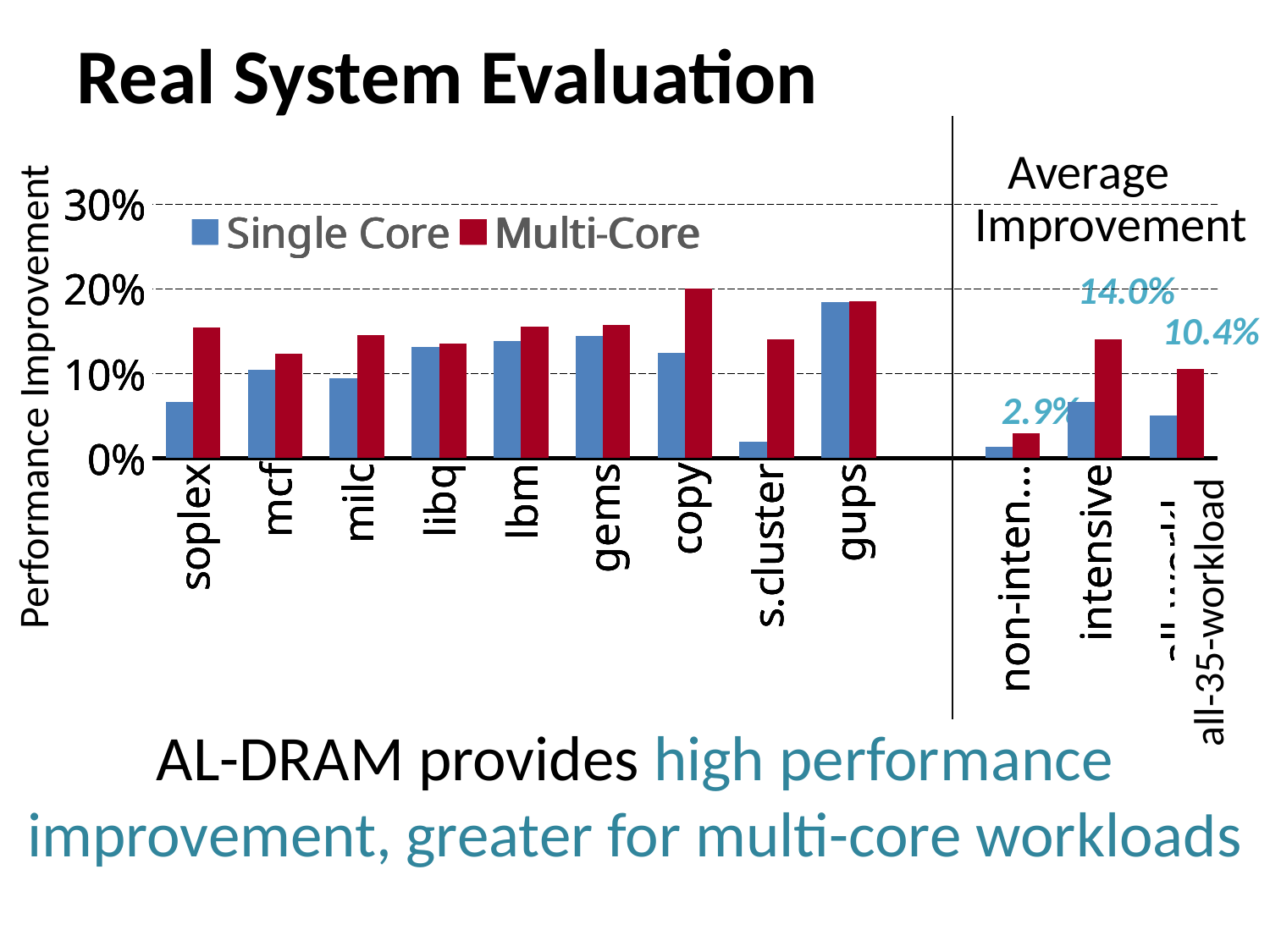
What are the two series named in the legend? Single Core and Multi-Core What is the difference between the Multi-Core average improvement for intensive workloads (14.0%) and for all-35-workload (10.4%)? 3.6% How many individual benchmarks are plotted to the left of the vertical divider line? 9 How many series does the legend list? 2 Among the nine individual benchmarks left of the divider, which has the highest Multi-Core performance improvement? copy Is the Multi-Core performance improvement for copy greater or less than 10%? greater Is the Single Core performance improvement for soplex greater or less than 10%? less Among the nine individual benchmarks left of the divider, which has the lowest Single Core performance improvement? s.cluster What kind of chart is shown on the slide? bar chart What is the Multi-Core average improvement for all-35-workload? 10.4% For copy, which is larger: the Single Core or the Multi-Core performance improvement? Multi-Core What is the Multi-Core average improvement for the intensive workloads? 14.0%